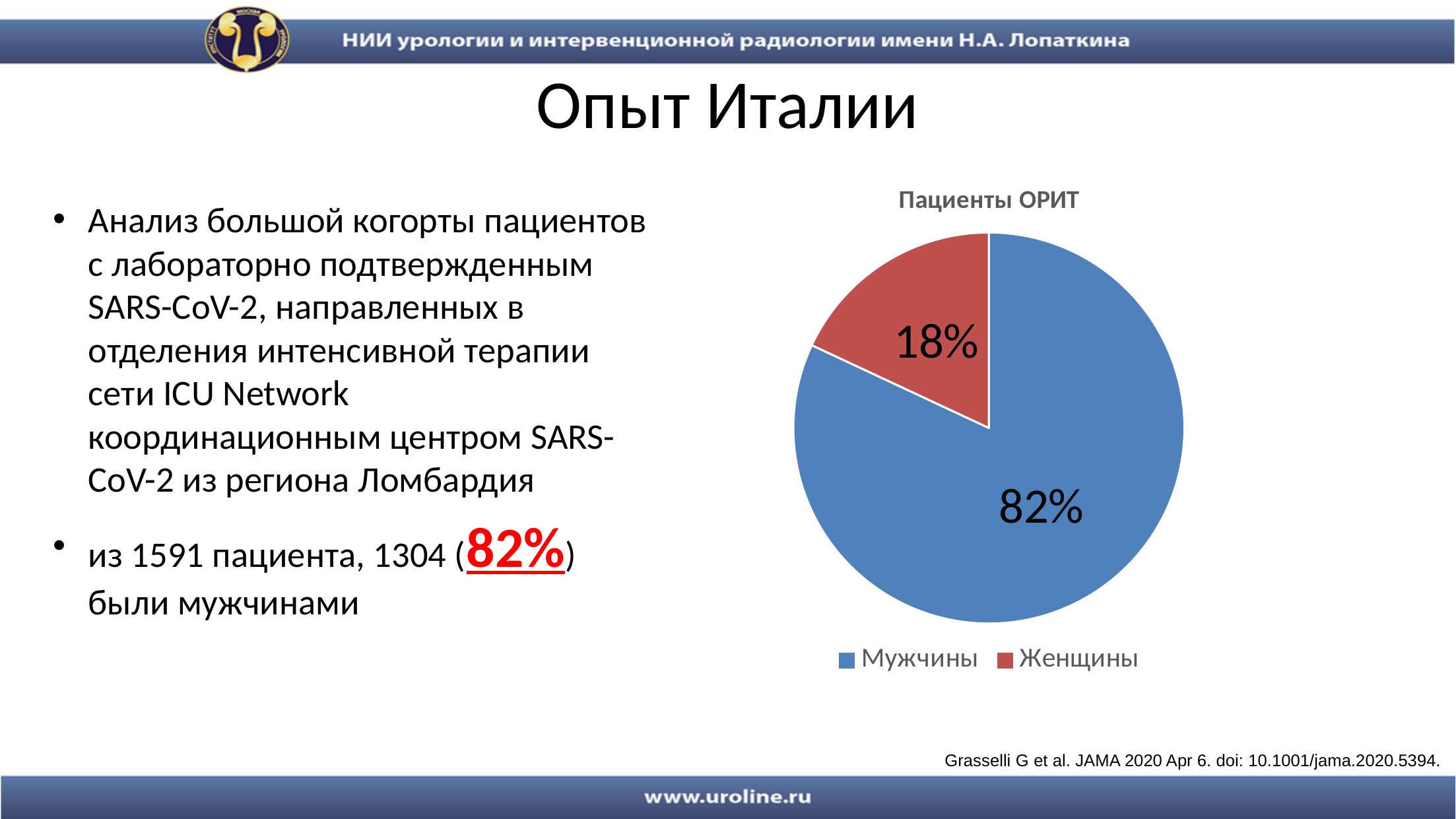
What share of the pie does Женщины represent? 18% What is the total of the two slices shown in the pie chart? 100% What is the difference in percentage points between the Мужчины and Женщины slices? 64 What is the title of the chart? Пациенты ОРИТ What share of the pie does Мужчины represent? 82% Which slice is larger, Мужчины or Женщины? Мужчины Which category has the smallest slice of the pie? Женщины Which category has the largest slice of the pie? Мужчины How many categories does the pie chart show? 2 What kind of chart is shown on the slide? Pie chart What colour is the Женщины slice? Red